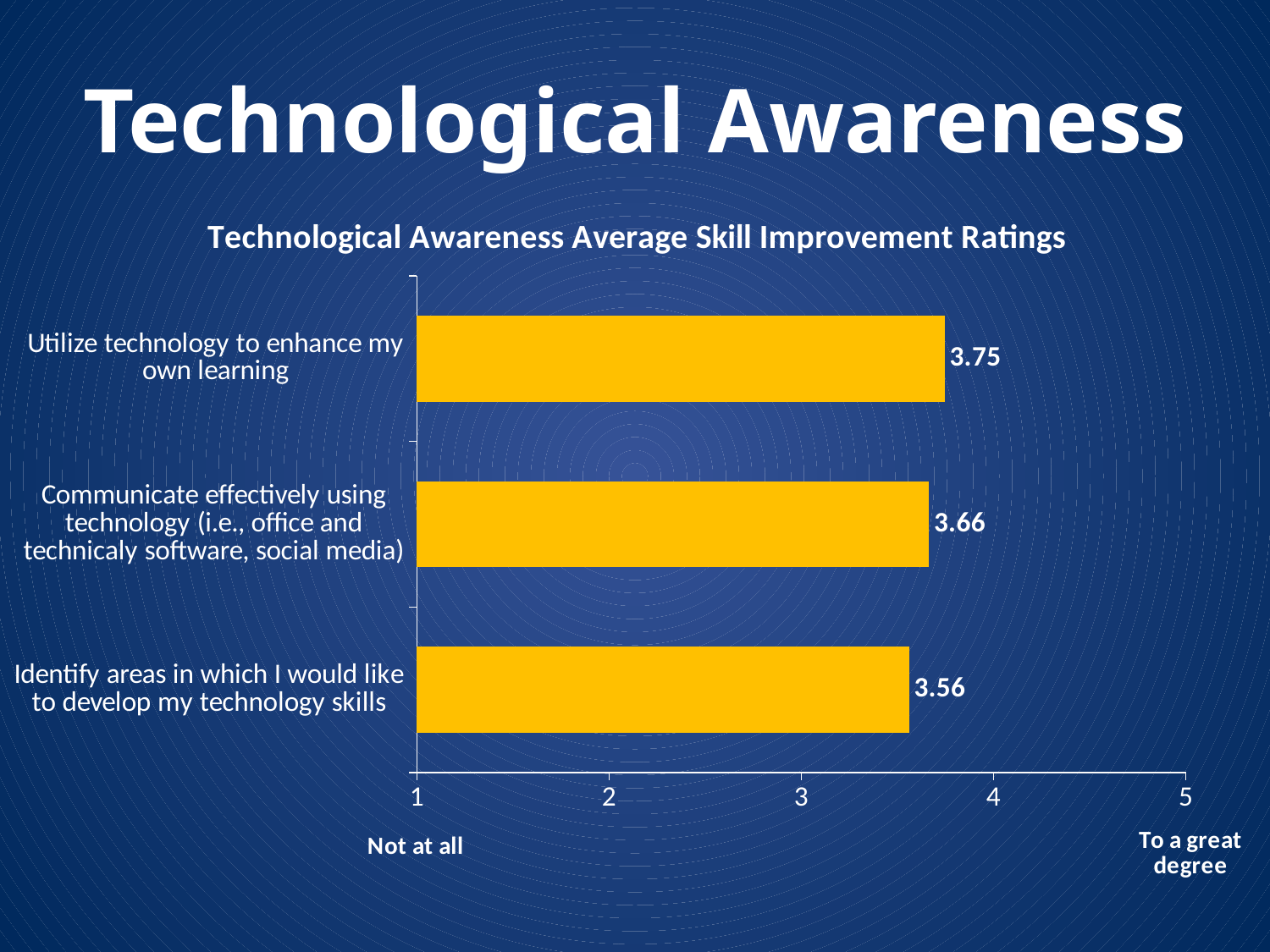
What is the title of the chart? Technological Awareness Average Skill Improvement Ratings Is the rating for "Identify areas in which I would like to develop my technology skills" greater or less than 4? less What is the difference between the ratings for "Communicate effectively using technology" and "Identify areas in which I would like to develop my technology skills"? 0.1 How many categories are shown in the chart? 3 What is the difference between the ratings for "Utilize technology to enhance my own learning" and "Identify areas in which I would like to develop my technology skills"? 0.19 What is the rating for "Communicate effectively using technology (i.e., office and technicaly software, social media)"? 3.66 What kind of chart is shown on the slide? Bar chart Which category has the highest average skill improvement rating? Utilize technology to enhance my own learning What is the average skill improvement rating for "Utilize technology to enhance my own learning"? 3.75 What is the rating for "Identify areas in which I would like to develop my technology skills"? 3.56 Which category has the lowest average skill improvement rating? Identify areas in which I would like to develop my technology skills Which has a higher rating: "Utilize technology to enhance my own learning" or "Communicate effectively using technology"? Utilize technology to enhance my own learning